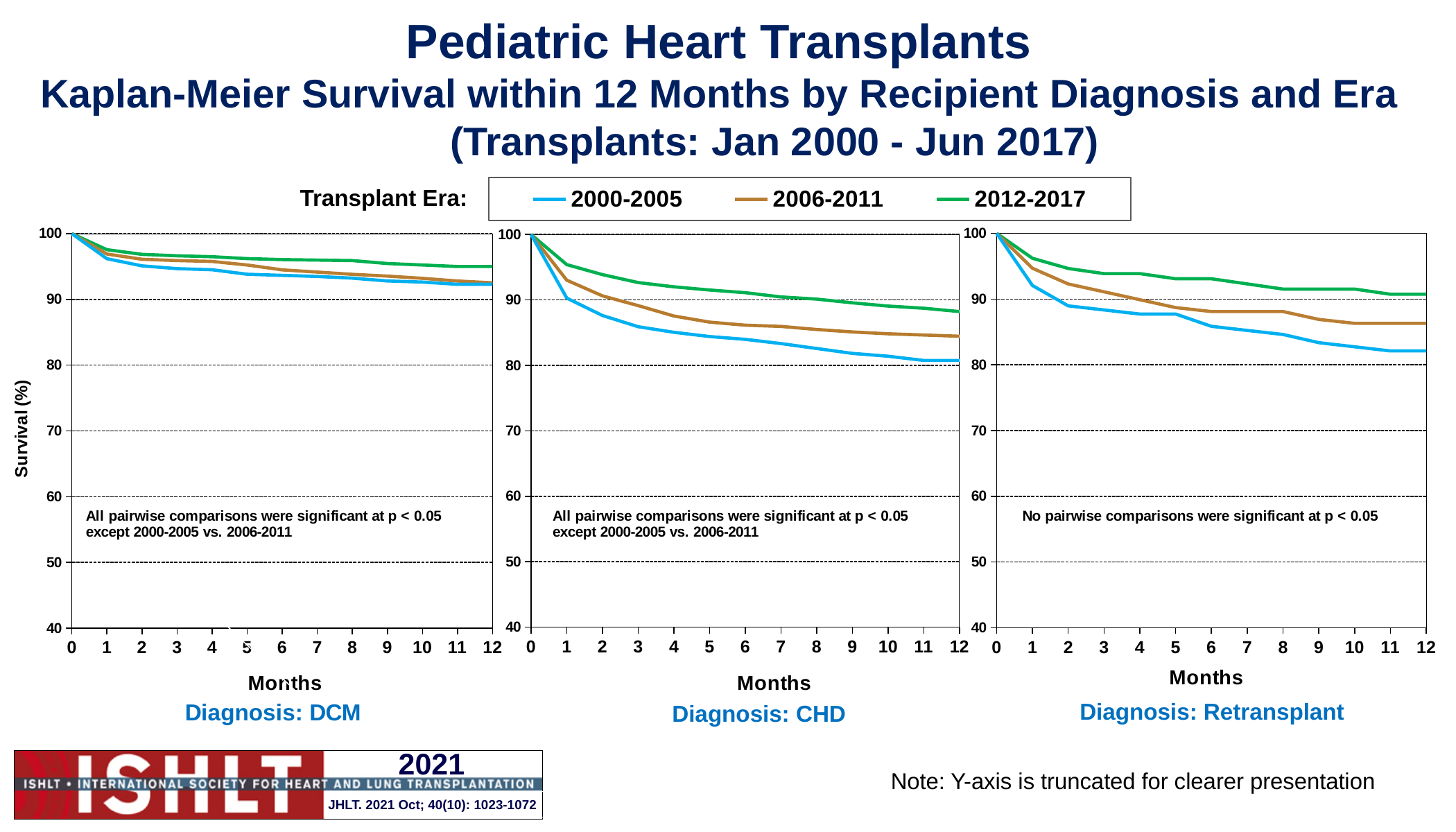
What kind of chart is used for the Diagnosis: DCM panel? Line chart In the Diagnosis: DCM chart, is the survival for 2000-2005 at 12 months greater or less than 90? greater In the Diagnosis: Retransplant chart, is the survival for 2000-2005 at 12 months greater or less than 80? greater In the Diagnosis: Retransplant chart, which transplant era has the lowest survival at 12 months? 2000-2005 In the Diagnosis: Retransplant chart, do the survival curves rise or fall as months increase? Fall In the Diagnosis: CHD chart, which transplant era has the highest survival at 12 months? 2012-2017 In the Diagnosis: CHD chart, which transplant era has the lowest survival at 12 months? 2000-2005 How many transplant eras does the legend list? 3 In the Diagnosis: DCM chart, what is the survival value for all eras at month 0? 100 In the Diagnosis: CHD chart, which is larger at 12 months: survival for 2006-2011 or for 2000-2005? 2006-2011 In the Diagnosis: CHD chart, is the survival for 2012-2017 at 12 months greater or less than 90? less Which transplant era is shown in green in the legend? 2012-2017